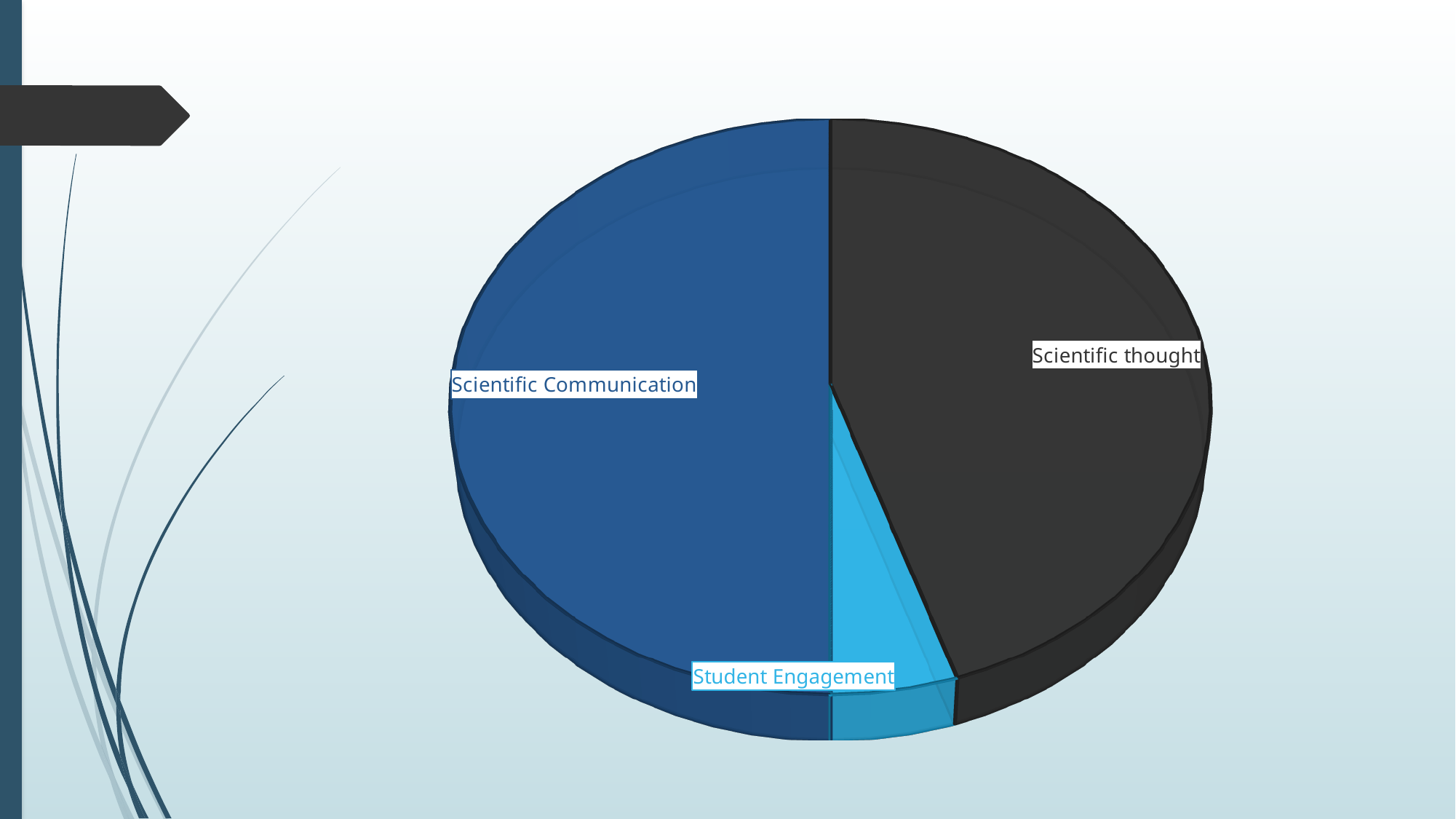
Which slice of the pie chart is the smallest? Student Engagement Does the Scientific Communication slice take up more or less than a quarter of the pie? more What colour is the Student Engagement slice? Light blue Which slice of the pie chart is the largest? Scientific Communication Which slice is larger, Scientific thought or Student Engagement? Scientific thought How many slices does the pie chart have? 3 Which slice is larger, Scientific Communication or Student Engagement? Scientific Communication What colour is the Scientific thought slice? Dark grey Which slice is larger, Scientific Communication or Scientific thought? Scientific Communication What kind of chart is shown on the slide? Pie chart Does the Student Engagement slice take up more or less than a quarter of the pie? less